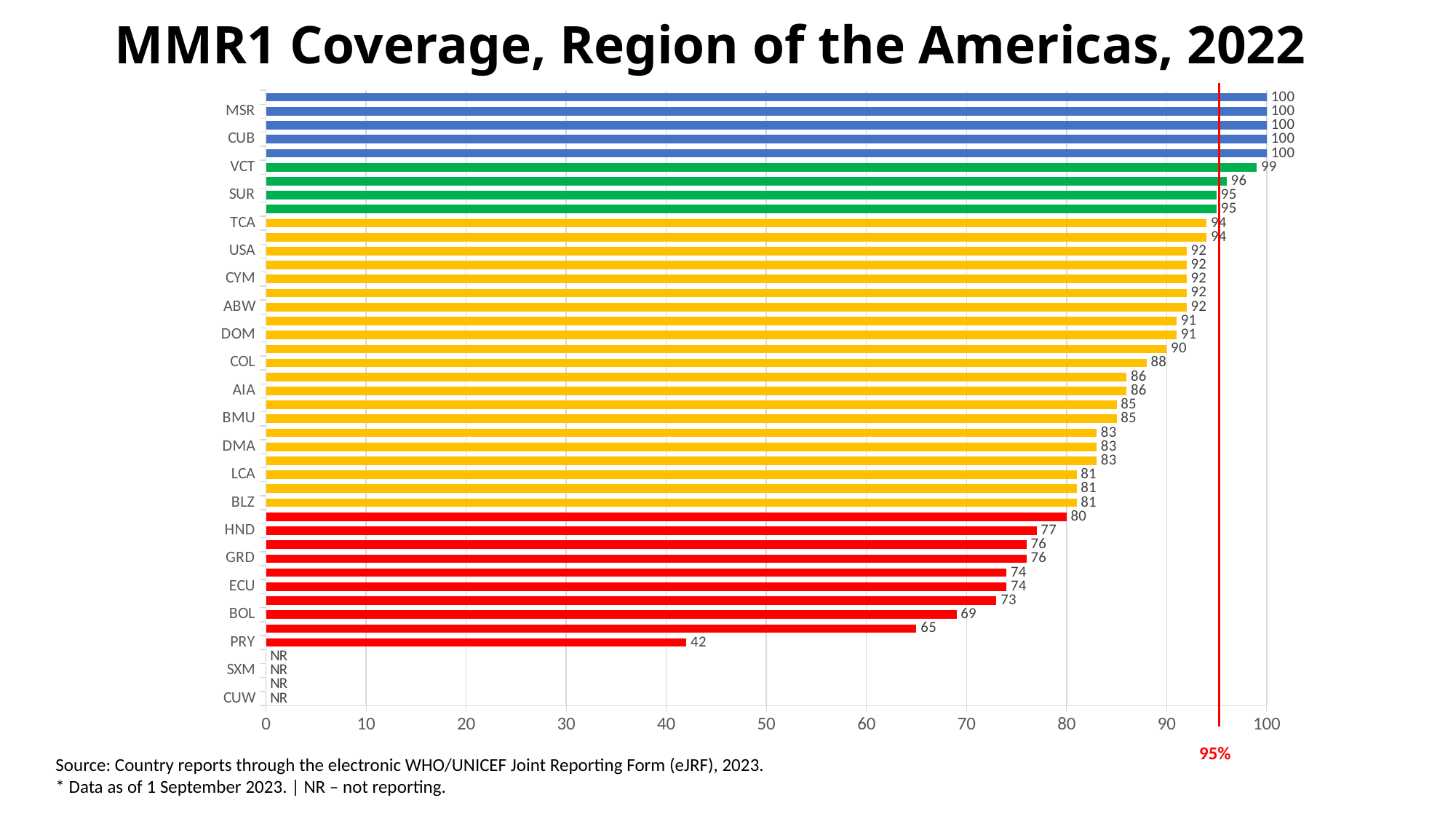
What is the difference between the MMR1 coverage values for VCT and PRY? 57 What kind of chart is shown on the slide? bar chart What is the MMR1 coverage value for PRY? 42 Which labelled country has the lowest plotted MMR1 coverage value? PRY What is the MMR1 coverage value for DOM? 91 Is the value for HND greater or less than 80? less What is the MMR1 coverage value for BOL? 69 What is the MMR1 coverage value for COL? 88 Which has a higher MMR1 coverage value, COL or BOL? COL What is the MMR1 coverage value for HND? 77 What value does the red vertical reference line on the chart mark? 95% What is the MMR1 coverage value for VCT? 99